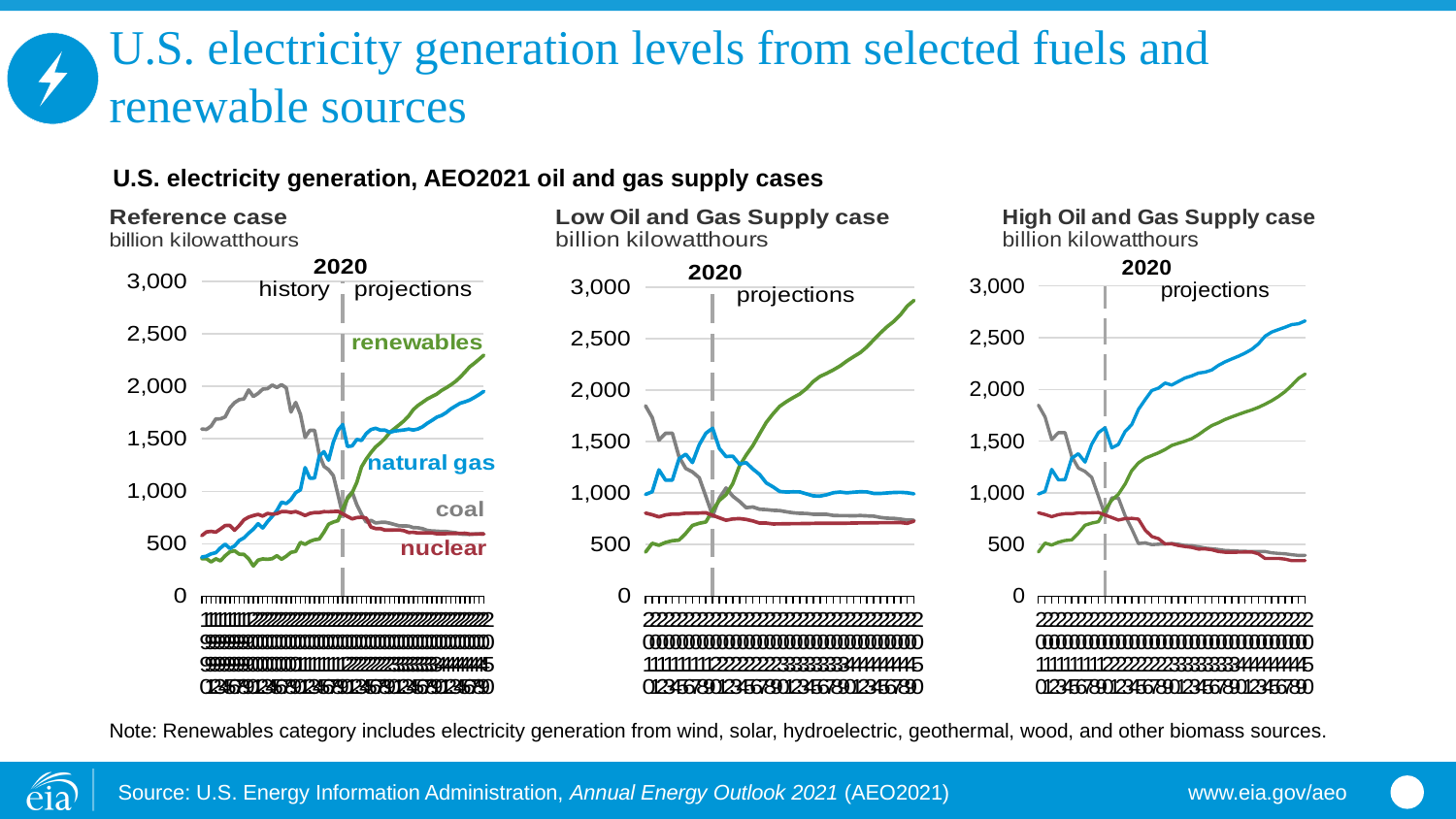
What unit is shown under each chart title? billion kilowatthours In the Low Oil and Gas Supply case chart, does the blue line rise or fall after 2020? fall How many charts are shown on the slide? 3 In the High Oil and Gas Supply case chart, which is higher at the end of the projections, the blue line or the green line? the blue line What kind of chart is used in the Reference case panel? line chart In the Reference case chart, does coal rise or fall over the projection period? fall In the Reference case chart, which series is highest at the end of the projection period? renewables In the Reference case chart, is the value for renewables at the end of the projections greater or less than 2,000? greater In the Reference case chart, is the value for natural gas at the end of the projections greater or less than 1,500? greater In the High Oil and Gas Supply case chart, is the blue line at the end of the projections greater or less than 2,500? greater In the Reference case chart, does renewables rise or fall over the projection period? rise